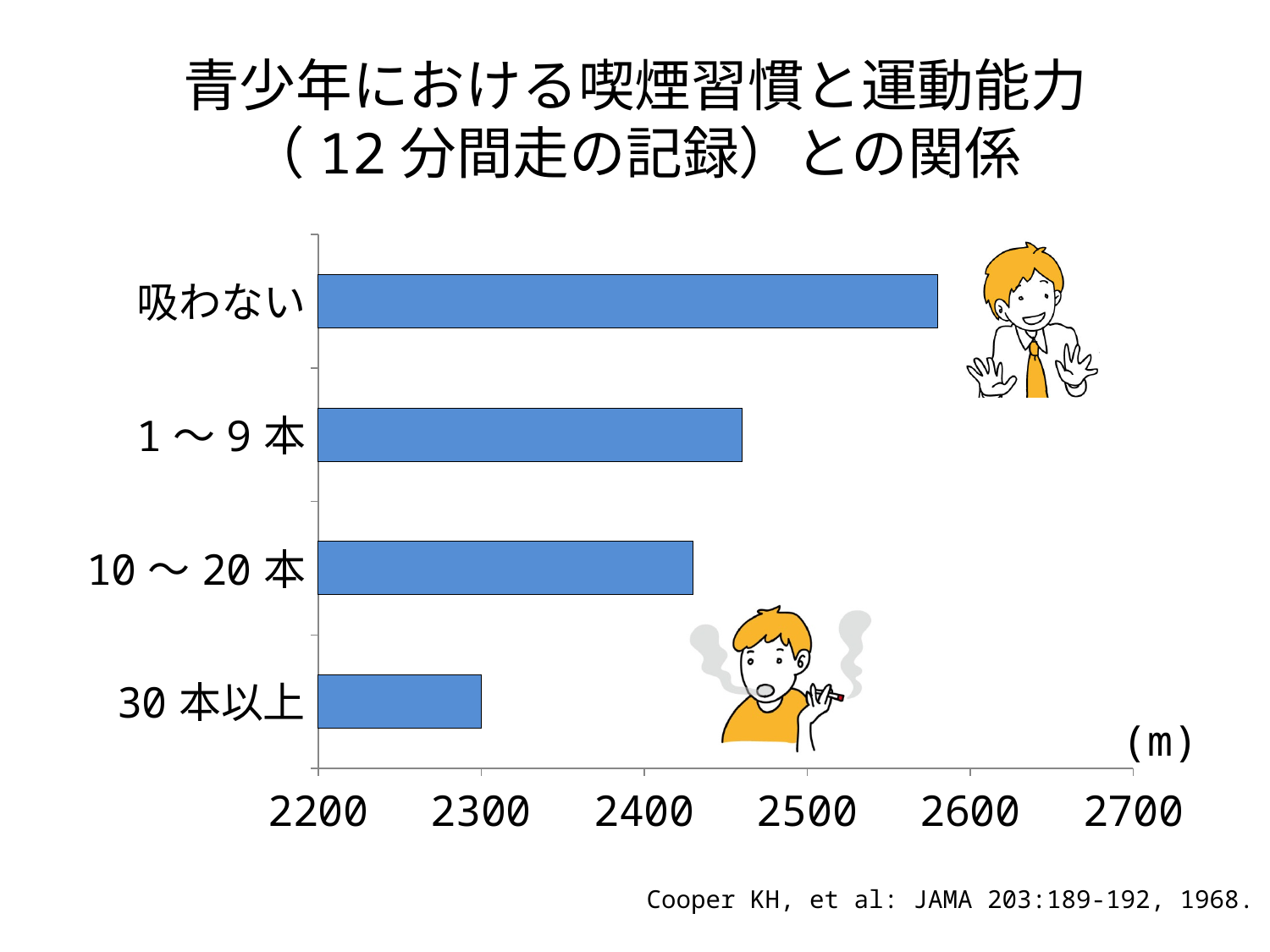
Do the run distances rise or fall as the number of cigarettes smoked increases? fall How many categories (smoking groups) are plotted in the chart? 4 Is the value for 30本以上 greater or less than 2400? less Is the value for 1～9本 greater or less than 2500? less Is the value for 10～20本 greater or less than 2400? greater Which is larger, the value for 10～20本 or the value for 吸わない? 吸わない Which is larger, the value for 1～9本 or the value for 30本以上? 1～9本 Which category has the lowest 12-minute run distance? 30本以上 What kind of chart is shown on the slide? bar chart Which category has the highest 12-minute run distance? 吸わない What unit is shown on the horizontal axis of the chart? (m)